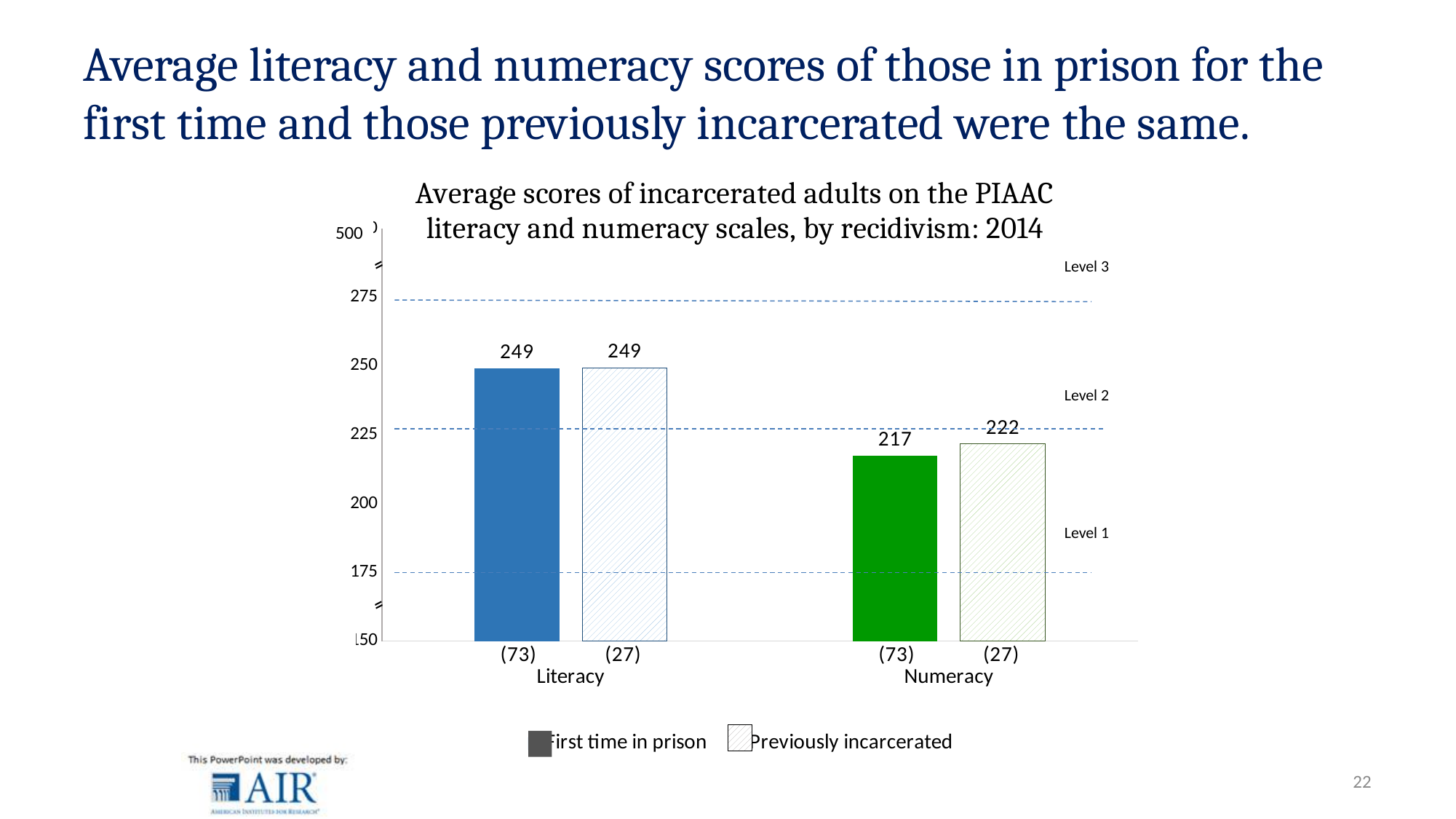
Which bar shows the lowest score on the chart? Numeracy, first time in prison What is the average literacy score for those previously incarcerated? 249 What is the average literacy score for those in prison for the first time? 249 What is the difference between the literacy and numeracy scores for those in prison for the first time? 32 What is the difference between the numeracy scores of previously incarcerated adults and first-time prisoners? 5 What is the average numeracy score for those in prison for the first time? 217 What is the average numeracy score for those previously incarcerated? 222 Is the literacy score for first-time prisoners greater or less than 225? greater Which is larger: the numeracy score for first-time prisoners or for previously incarcerated adults? Previously incarcerated What kind of chart is shown on the slide? Bar chart How many series does the legend list? 2